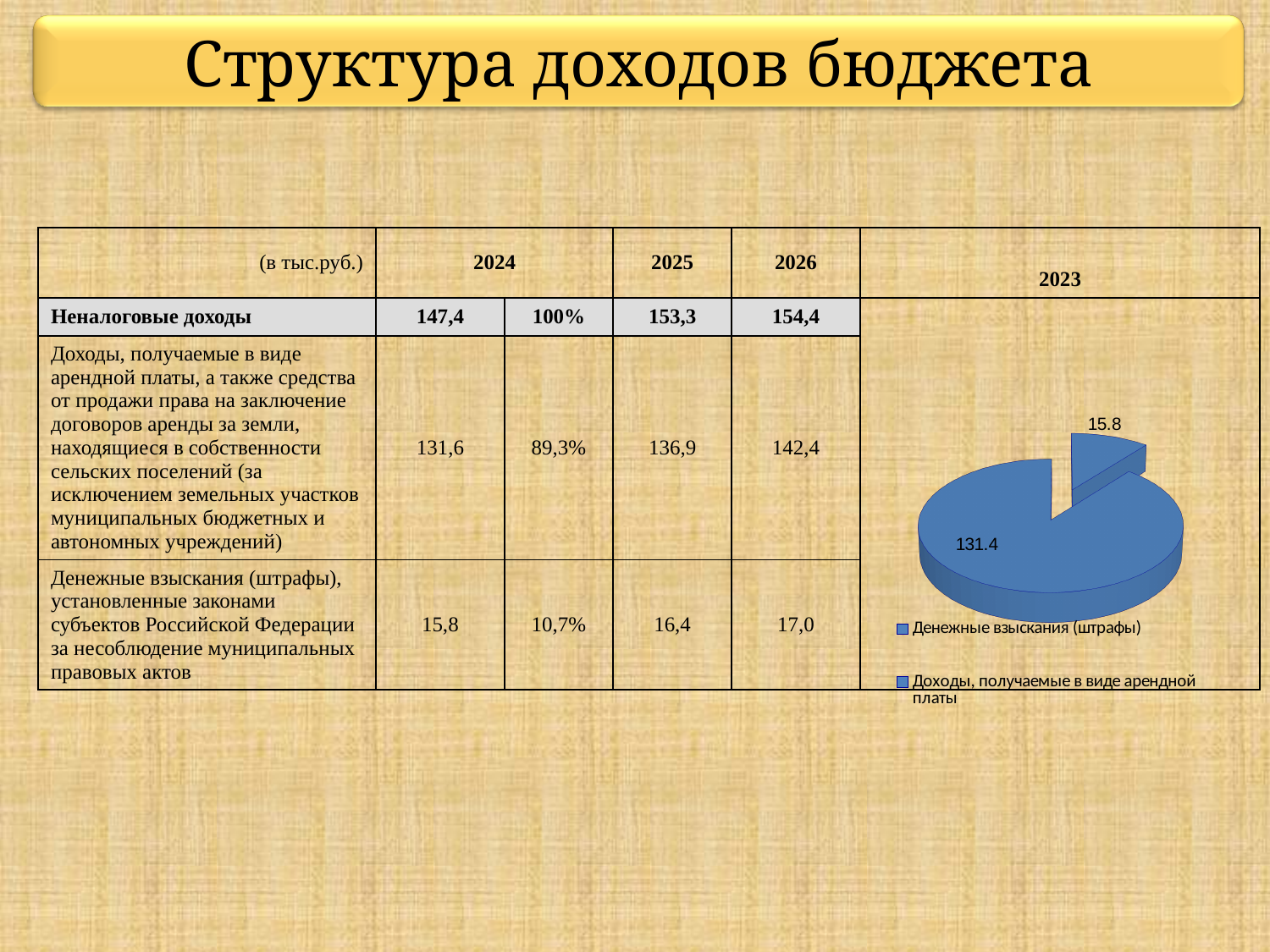
What kind of chart is shown on the slide? pie chart How many entries does the legend of the pie chart list? 2 Which legend entry is listed first under the pie chart? Денежные взыскания (штрафы) What is the difference between the two slice values in the pie chart? 115.6 What is the total of the two slices in the pie chart? 147.2 What is the value of the largest slice in the pie chart? 131.4 What share of the pie does the slice labelled 131.4 represent? 89.3% What is the value of the smallest slice in the pie chart? 15.8 Is the exploded (pulled-out) slice of the pie chart the larger or the smaller slice? smaller What share of the pie does the slice labelled 15.8 represent? 10.7% What is the title of the pie chart? 2023 How many slices does the pie chart have? 2